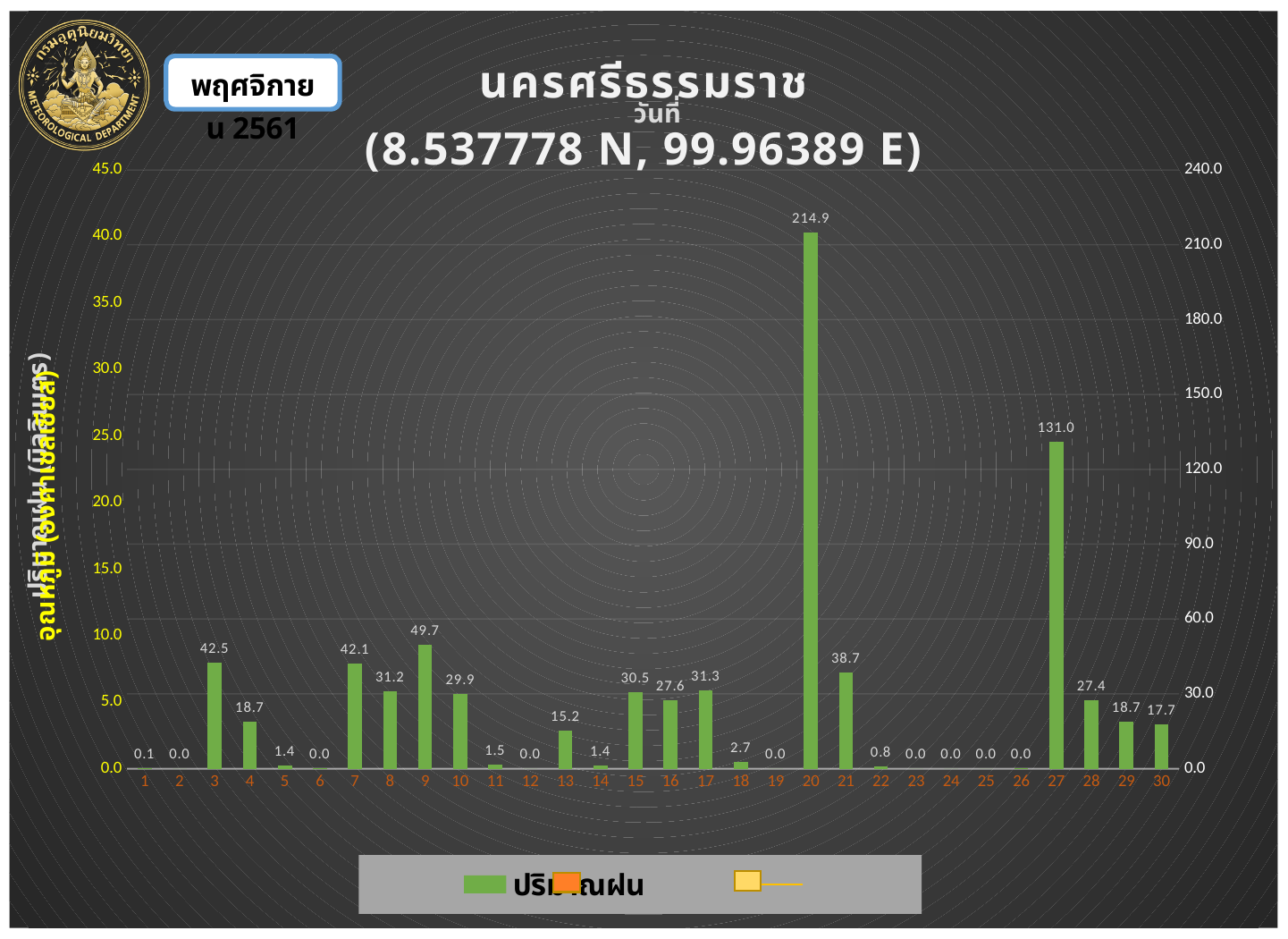
Is the rainfall value for day 27 greater or less than 120.0 on the right axis? greater How many days are shown on the x axis? 30 What is the rainfall value for day 27? 131.0 What is the maximum value shown on the right-hand axis? 240.0 What is the rainfall value for day 13? 15.2 Which day has the highest rainfall value? 20 What is the rainfall value for day 9? 49.7 What kind of chart is shown on the slide? bar chart What is the difference between the rainfall values for day 3 and day 4? 23.8 Which is larger, the rainfall value for day 21 or for day 8? day 21 What is the difference between the rainfall values for day 20 and day 27? 83.9 What is the rainfall value for day 20? 214.9